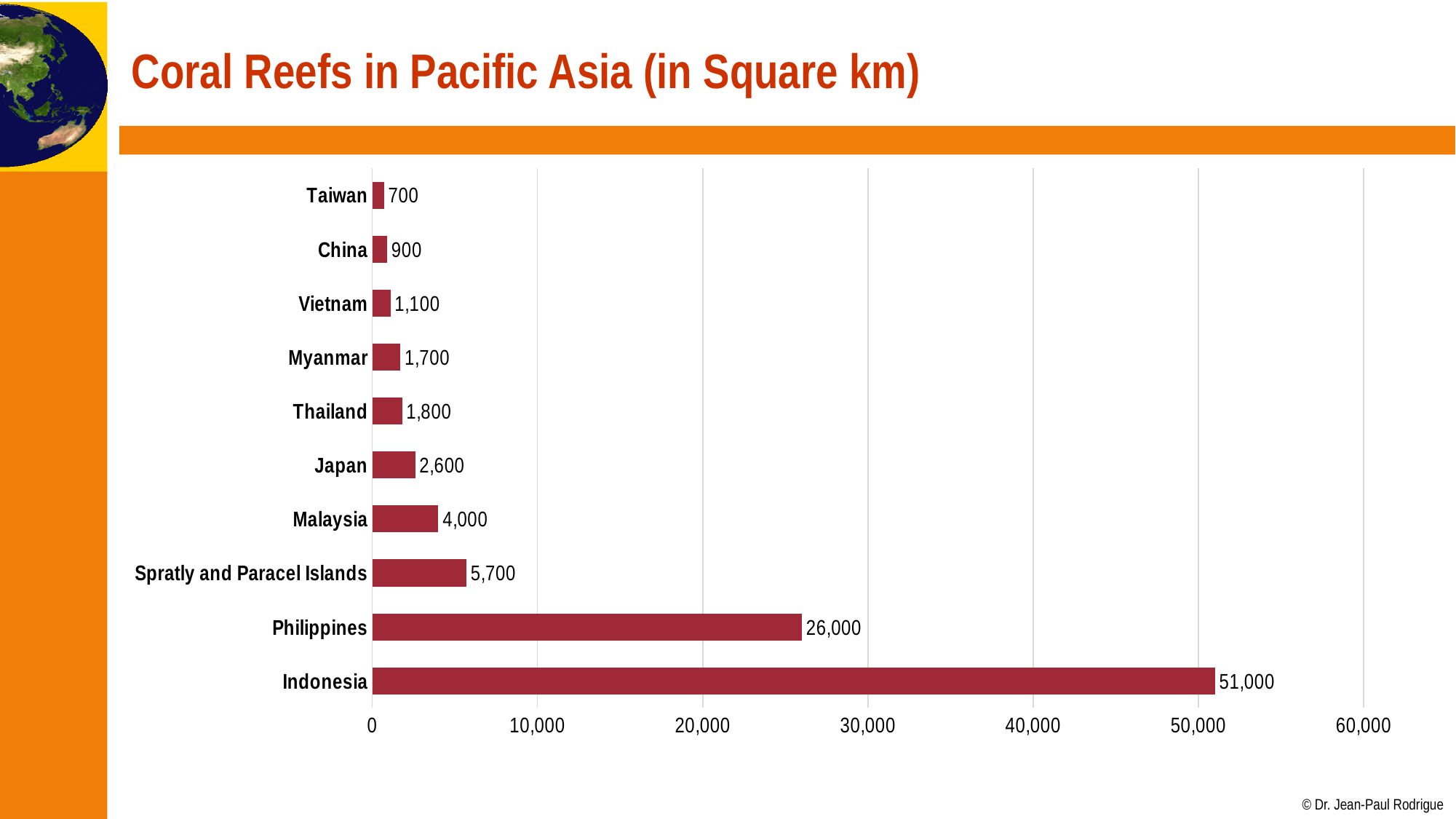
What is the title of the chart? Coral Reefs in Pacific Asia (in Square km) Which has a larger coral reef area, Malaysia or Japan? Malaysia How many countries or territories are shown in the chart? 10 What is the coral reef area for the Spratly and Paracel Islands? 5,700 What kind of chart is shown on the slide? Bar chart Which country has the smallest coral reef area? Taiwan What is the coral reef area for Malaysia? 4,000 Is the value for the Philippines greater or less than 20,000? greater What is the difference between the coral reef areas of Indonesia and the Philippines? 25,000 What is the coral reef area for Indonesia? 51,000 Which country has the largest coral reef area? Indonesia What is the difference between the coral reef areas of Japan and Thailand? 800